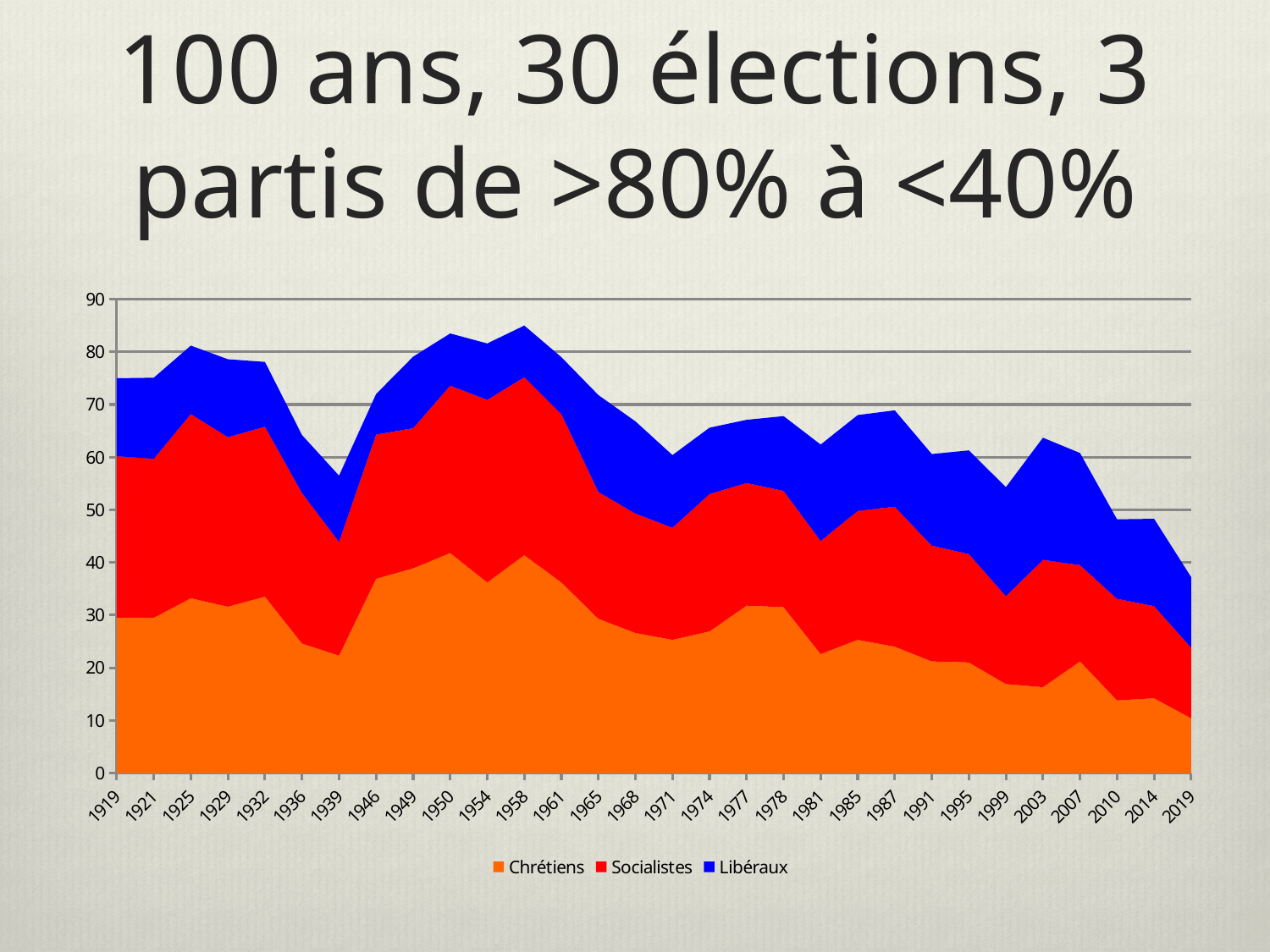
Is the value for Chrétiens in 1939 greater or less than 30? less Does the combined total of the three parties rise or fall between 1987 and 2019? fall Is the combined total of the three parties larger in 1958 or in 2019? 1958 In which year is the combined total of the three parties highest? 1958 Is the combined total of the three parties in 1958 greater or less than 80? greater Which series is shown in blue? Libéraux How many election years are plotted along the x axis? 30 What are the three series named in the legend? Chrétiens, Socialistes, Libéraux What kind of chart is shown on the slide? Stacked area chart How many series does the legend list? 3 Is the combined total of the three parties in 2019 greater or less than 40? less In which year is the combined total of the three parties lowest? 2019